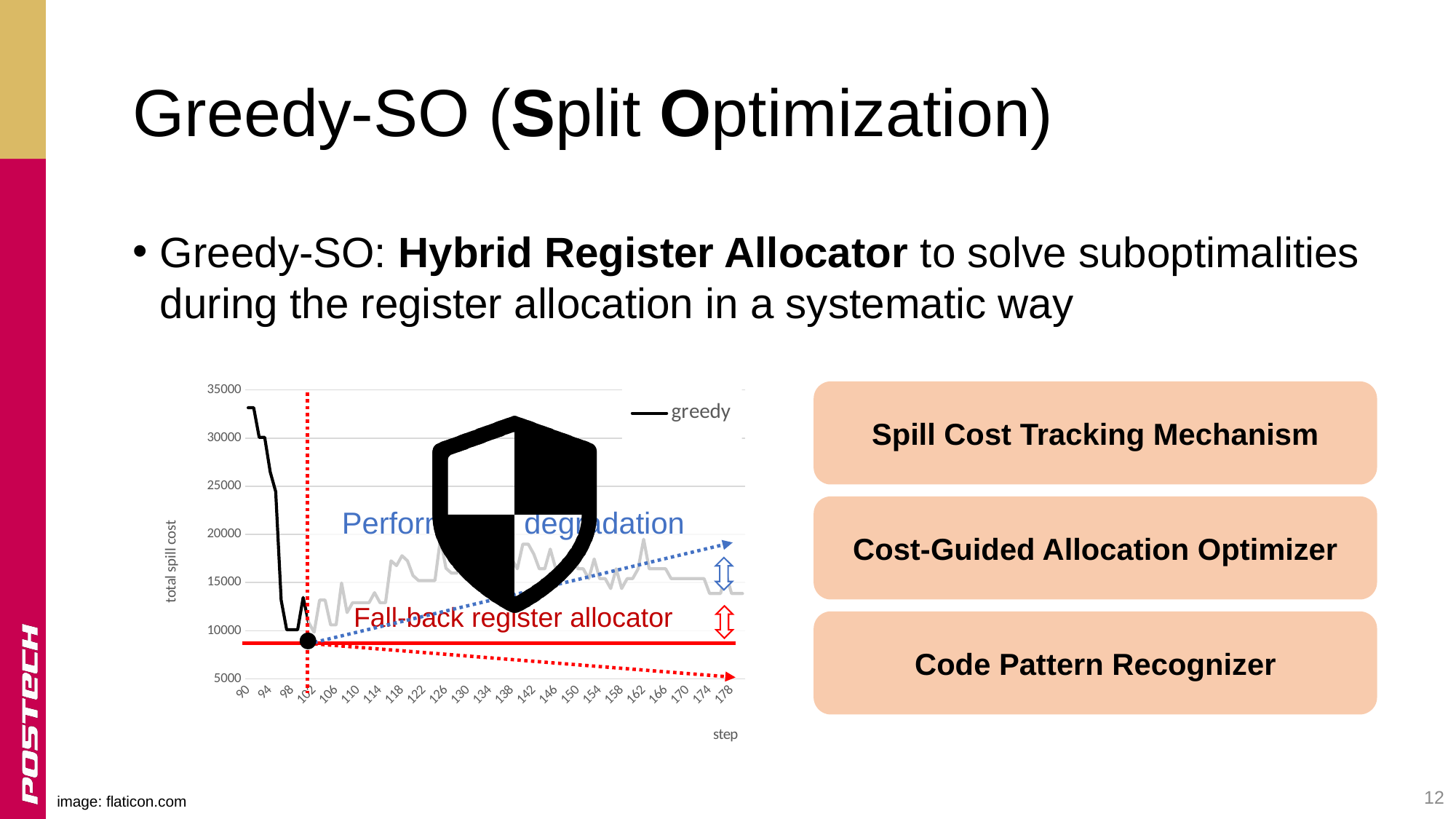
How many step labels are shown along the horizontal axis? 23 What is the name of the series shown in the chart legend? greedy Is the greedy value at step 90 greater or less than 30000? greater How many series does the chart legend list? 1 Is the greedy value at step 178 greater or less than 20000? less What is the highest tick value shown on the vertical axis? 35000 Is the greedy value at step 98 greater or less than 15000? less What is the last step label shown on the horizontal axis? 178 What kind of chart is shown on the slide? line chart What is the label of the chart's vertical axis? total spill cost What is the lowest tick value shown on the vertical axis? 5000 Does the greedy line rise or fall between step 90 and step 98? fall